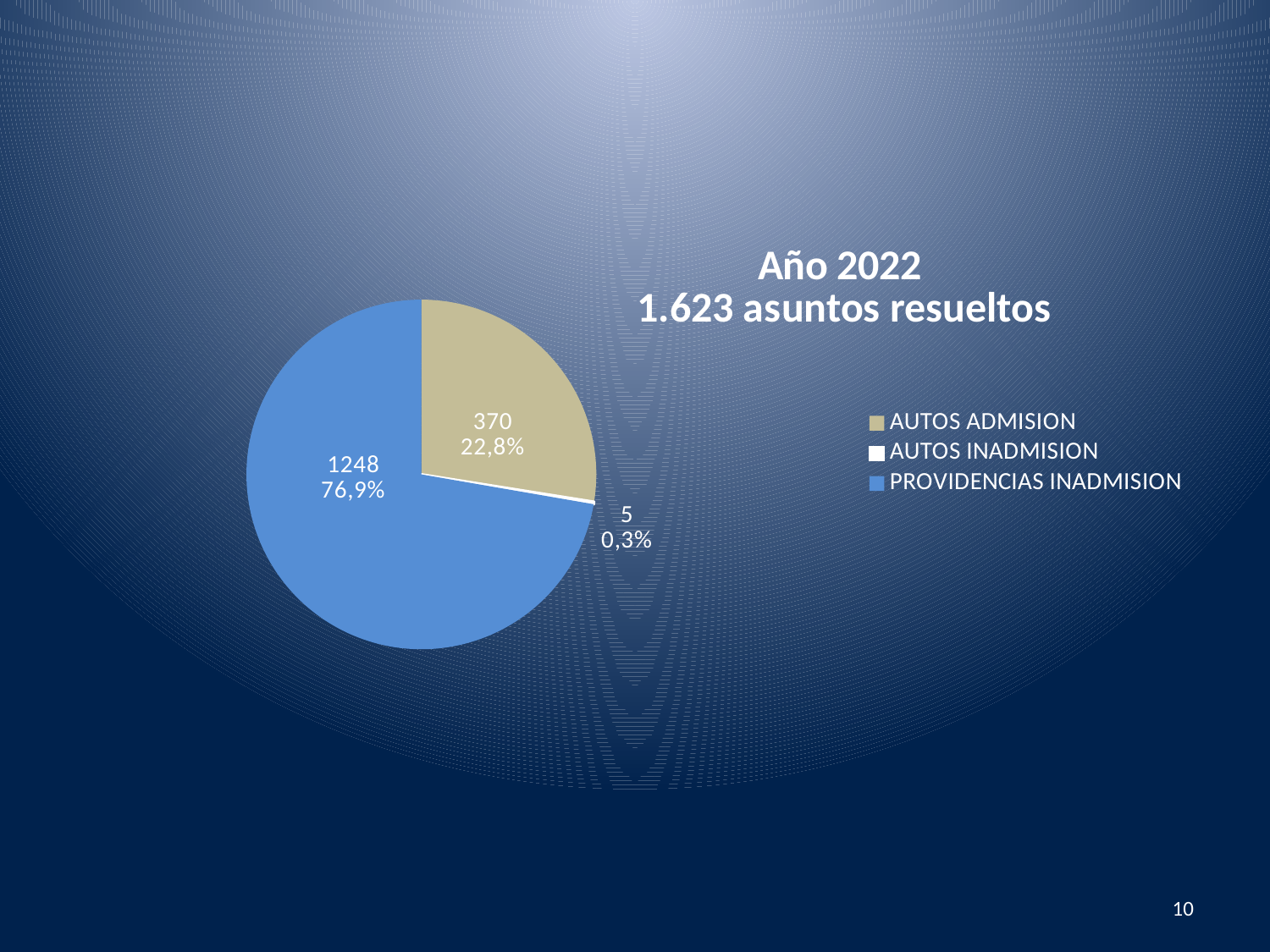
What is the value for AUTOS ADMISION? 370 What type of chart is shown on the slide? pie chart Which category has the largest slice? PROVIDENCIAS INADMISION What is the value for AUTOS INADMISION? 5 What is the title of the chart? Año 2022 1.623 asuntos resueltos What share of the pie does AUTOS ADMISION represent? 22,8% How many categories does the legend list? 3 What is the value for PROVIDENCIAS INADMISION? 1248 Which category has the smallest slice? AUTOS INADMISION What share of the pie does PROVIDENCIAS INADMISION represent? 76,9% What is the difference between the values for PROVIDENCIAS INADMISION and AUTOS ADMISION? 878 What share of the pie does AUTOS INADMISION represent? 0,3%